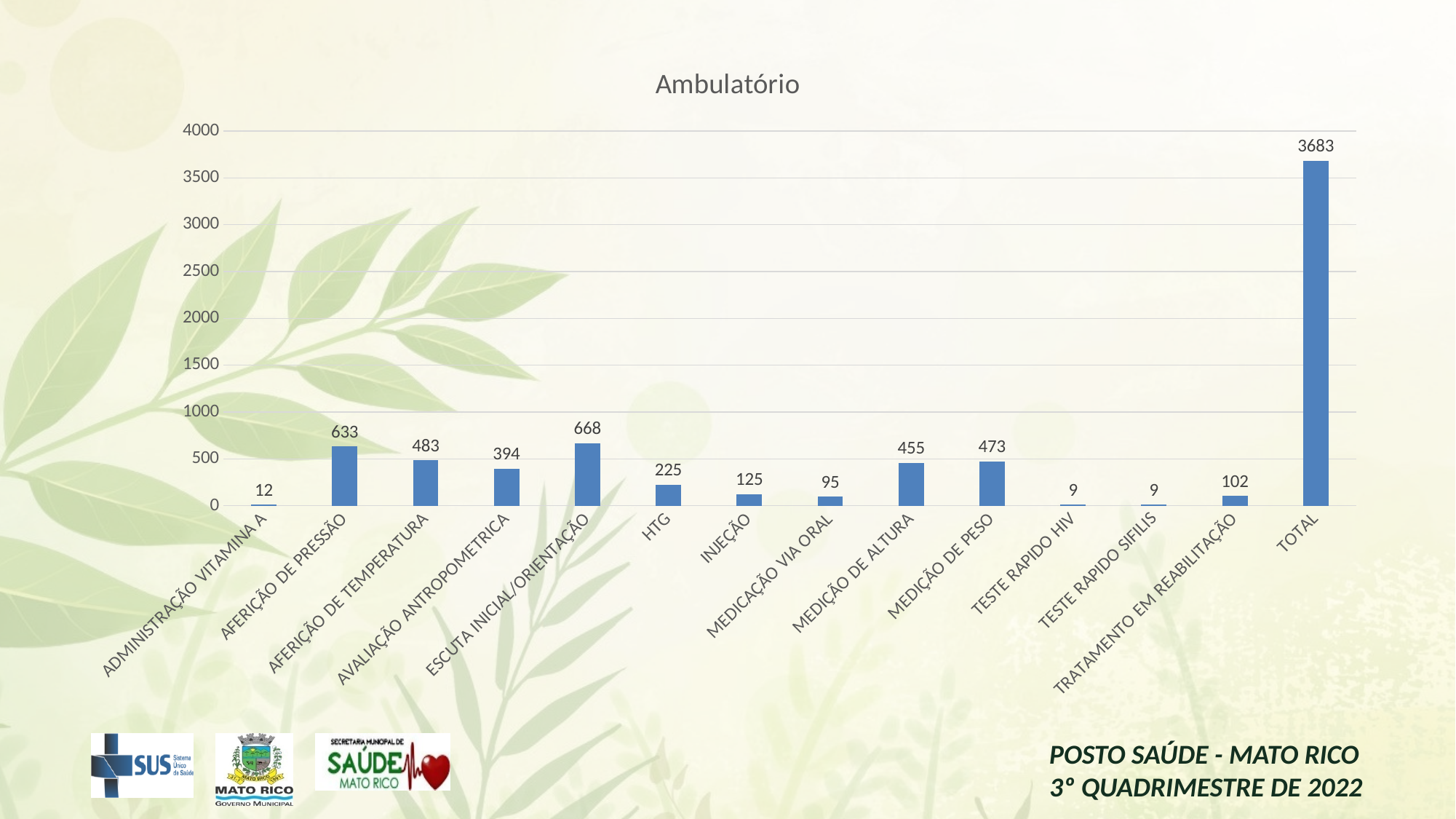
Which is larger, AFERIÇÃO DE TEMPERATURA or AVALIAÇÃO ANTROPOMETRICA? AFERIÇÃO DE TEMPERATURA What is the title of the chart? Ambulatório What is the difference between MEDIÇÃO DE PESO and MEDIÇÃO DE ALTURA? 18 What is the value for AFERIÇÃO DE PRESSÃO? 633 What is the value for TOTAL? 3683 What is the value for HTG? 225 What kind of chart is shown on the slide? bar chart How many categories are shown on the x axis? 14 Is the value for TOTAL greater or less than 3500? greater Excluding the TOTAL bar, which category has the highest value? ESCUTA INICIAL/ORIENTAÇÃO What is the value for ESCUTA INICIAL/ORIENTAÇÃO? 668 Which categories have the lowest value? TESTE RAPIDO HIV and TESTE RAPIDO SIFILIS